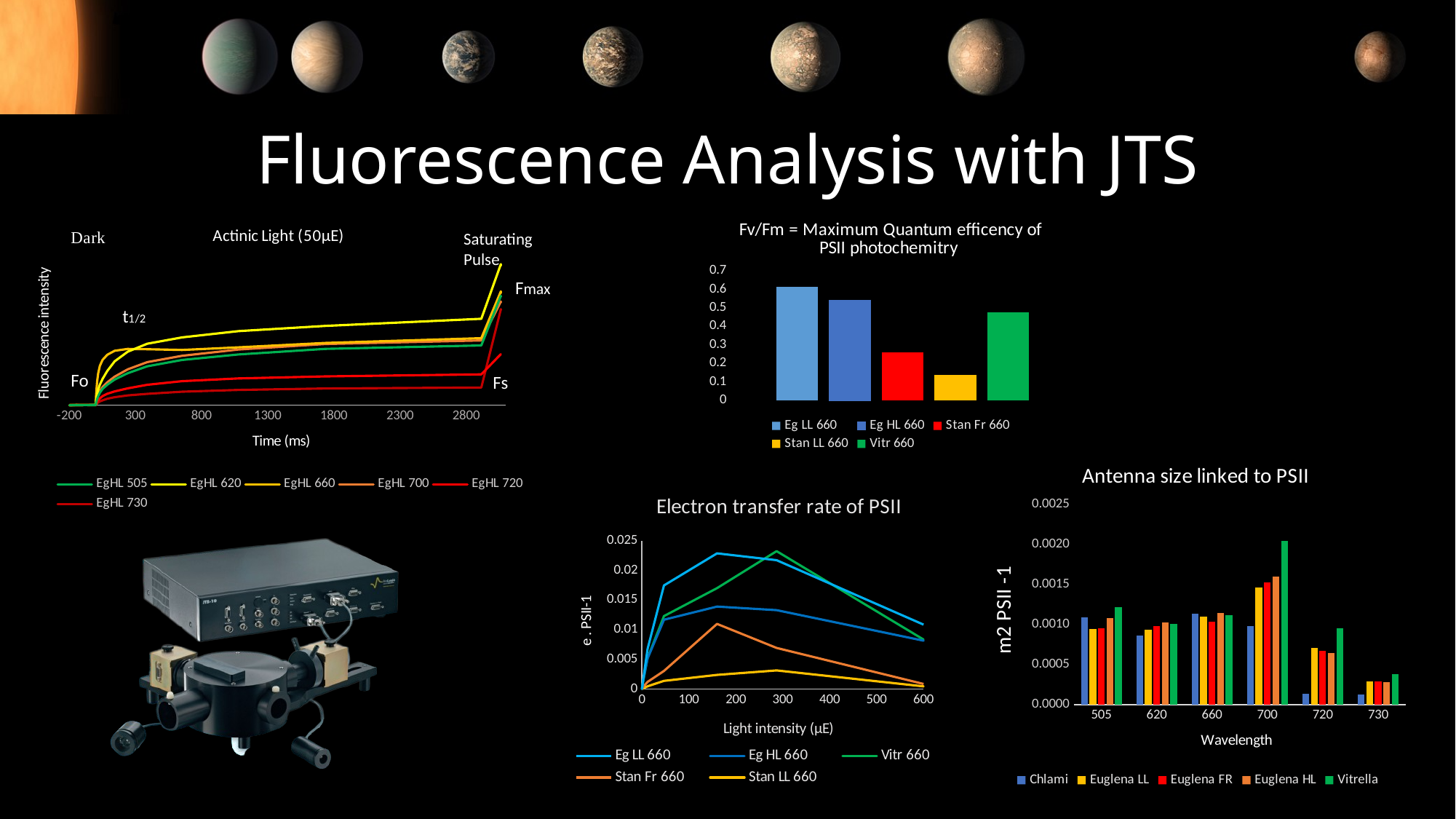
How many series does the legend of the 'Fv/Fm = Maximum Quantum efficency of PSII photochemistry' chart list? 5 In the 'Fv/Fm = Maximum Quantum efficency of PSII photochemistry' chart, is the value for Stan LL 660 greater or less than 0.2? less In the 'Antenna size linked to PSII' chart, is the Vitrella value at wavelength 700 greater or less than 0.0015? greater In the 'Electron transfer rate of PSII' chart, which series has the lowest values across the light intensities? Stan LL 660 In the 'Fv/Fm = Maximum Quantum efficency of PSII photochemistry' chart, which category has the highest value? Eg LL 660 What kind of chart is 'Electron transfer rate of PSII'? line chart How many series does the legend of the top-left fluorescence intensity chart list? 6 In the 'Fv/Fm = Maximum Quantum efficency of PSII photochemistry' chart, which is larger: Vitr 660 or Stan Fr 660? Vitr 660 In the 'Fv/Fm = Maximum Quantum efficency of PSII photochemistry' chart, which category has the lowest value? Stan LL 660 In the 'Electron transfer rate of PSII' chart, does the Stan Fr 660 series rise or fall between light intensity 300 and 600? fall In the 'Fv/Fm = Maximum Quantum efficency of PSII photochemistry' chart, is the value for Eg LL 660 greater or less than 0.5? greater How many wavelength categories are shown on the x axis of the 'Antenna size linked to PSII' chart? 6